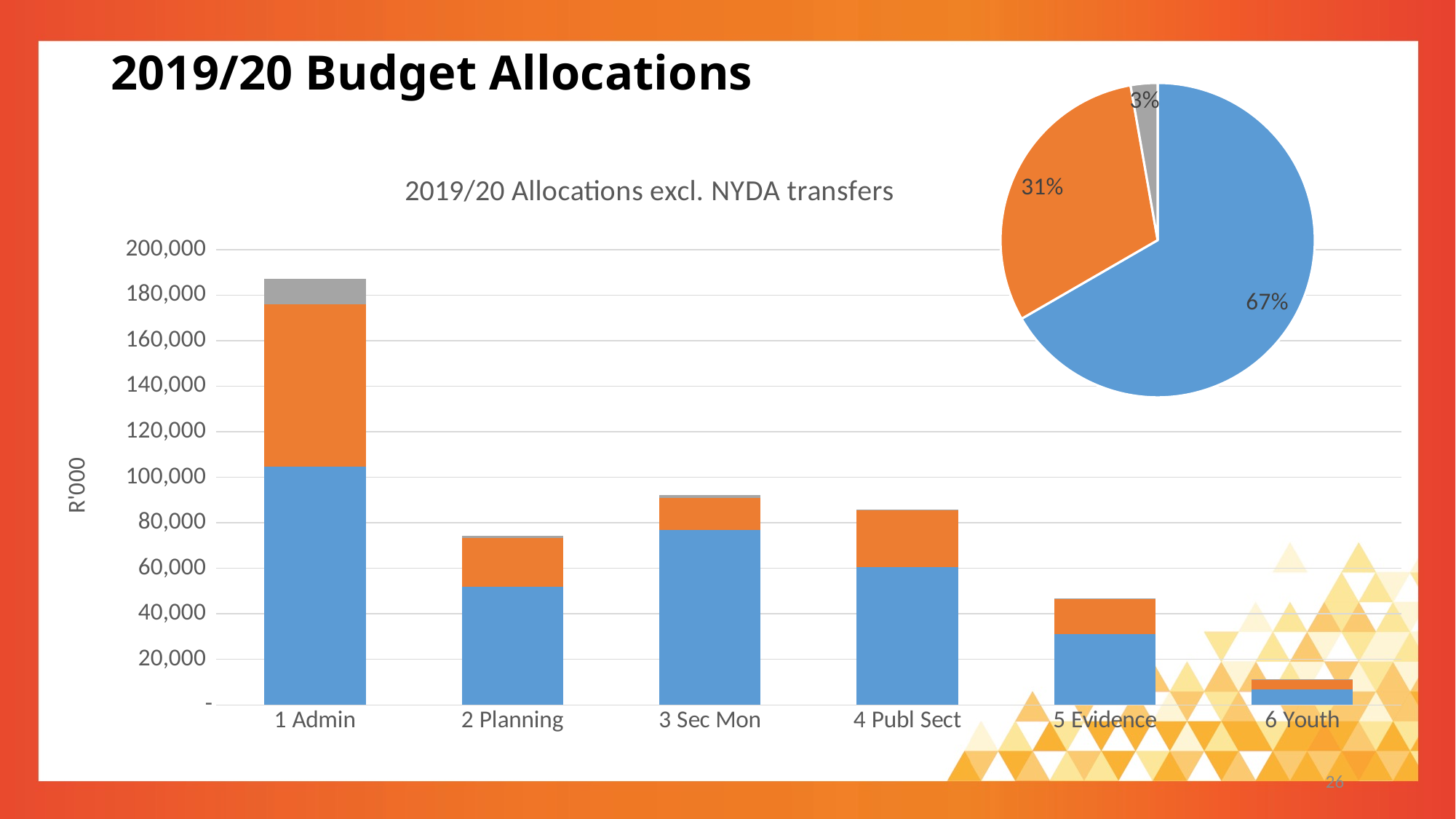
In the bar chart titled '2019/20 Allocations excl. NYDA transfers', is the total stacked value for 5 Evidence greater or less than 60,000? less In the bar chart titled '2019/20 Allocations excl. NYDA transfers', is the total stacked value for 6 Youth greater or less than 20,000? less In the pie chart at the top right of the slide, what share does the largest slice have? 67% In the bar chart titled '2019/20 Allocations excl. NYDA transfers', is the total stacked value for 1 Admin greater or less than 180,000? greater What kind of chart is the chart titled '2019/20 Allocations excl. NYDA transfers'? bar chart In the bar chart titled '2019/20 Allocations excl. NYDA transfers', which has the larger total stacked bar, 2 Planning or 5 Evidence? 2 Planning In the bar chart titled '2019/20 Allocations excl. NYDA transfers', which category has the shortest stacked bar? 6 Youth What is the label on the vertical axis of the bar chart titled '2019/20 Allocations excl. NYDA transfers'? R'000 In the pie chart at the top right of the slide, what is the difference between the largest slice (67%) and the second largest slice (31%)? 36% How many categories are shown on the x axis of the bar chart titled '2019/20 Allocations excl. NYDA transfers'? 6 In the bar chart titled '2019/20 Allocations excl. NYDA transfers', which category has the tallest stacked bar? 1 Admin